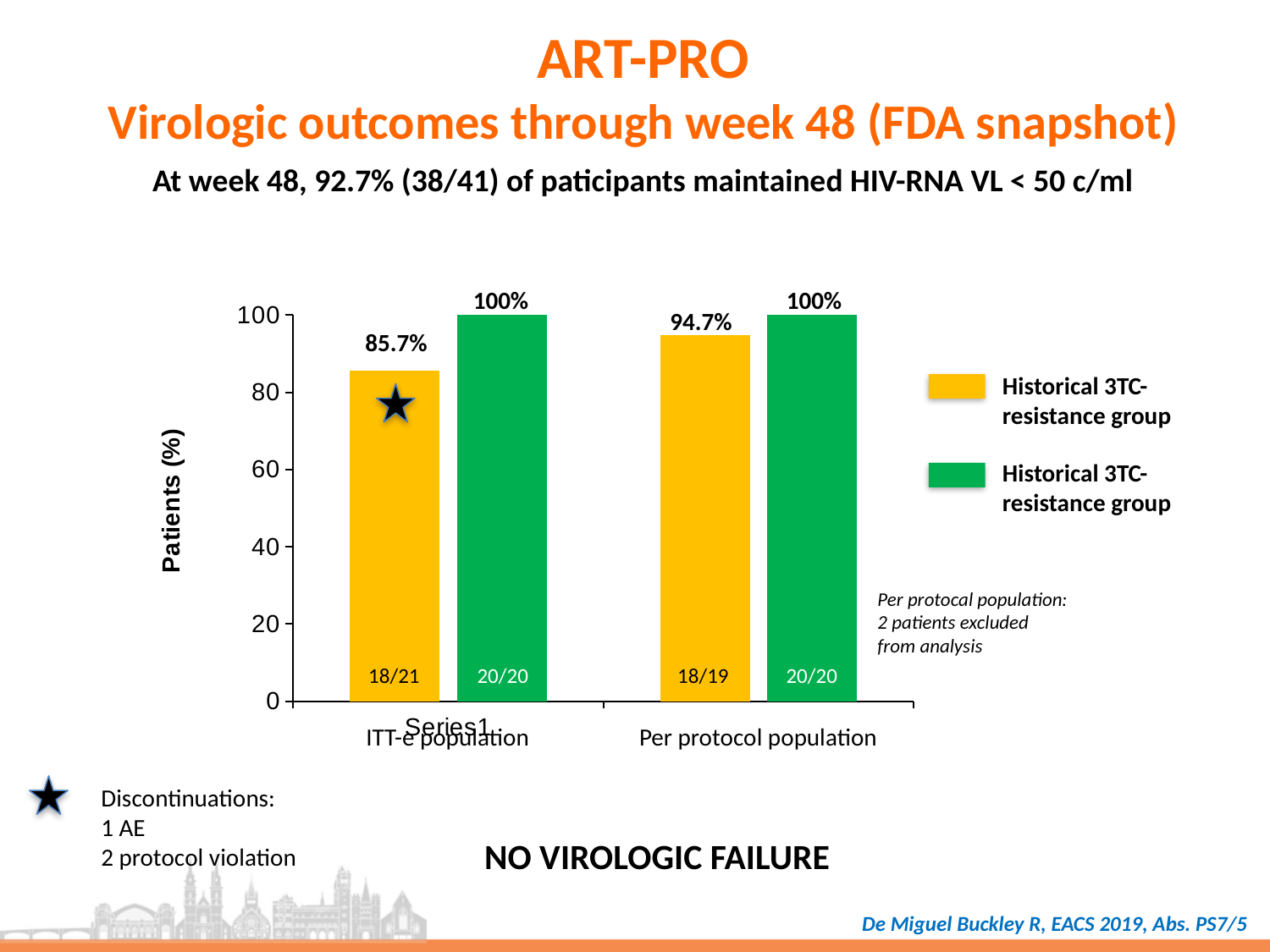
What is the value of the yellow bar for the Per protocol population? 94.7% What is the label of the y axis of the chart? Patients (%) What fraction is printed inside the yellow bar for the Per protocol population? 18/19 Does the yellow bar for the Per protocol population rise or fall compared with the yellow bar for the ITT-e population? rise What fraction is printed inside the yellow bar for the ITT-e population? 18/21 Which is larger: the yellow bar for the ITT-e population or the yellow bar for the Per protocol population? Per protocol population What is the value of the green bar for the ITT-e population? 100% What is the difference between the green bar and the yellow bar for the ITT-e population? 14.3% What is the value of the yellow bar for the ITT-e population? 85.7% How many categories are shown on the x axis of the chart? 2 What kind of chart is shown on the slide? bar chart Which bar has the lowest value in the chart? The yellow bar for the ITT-e population (85.7%)